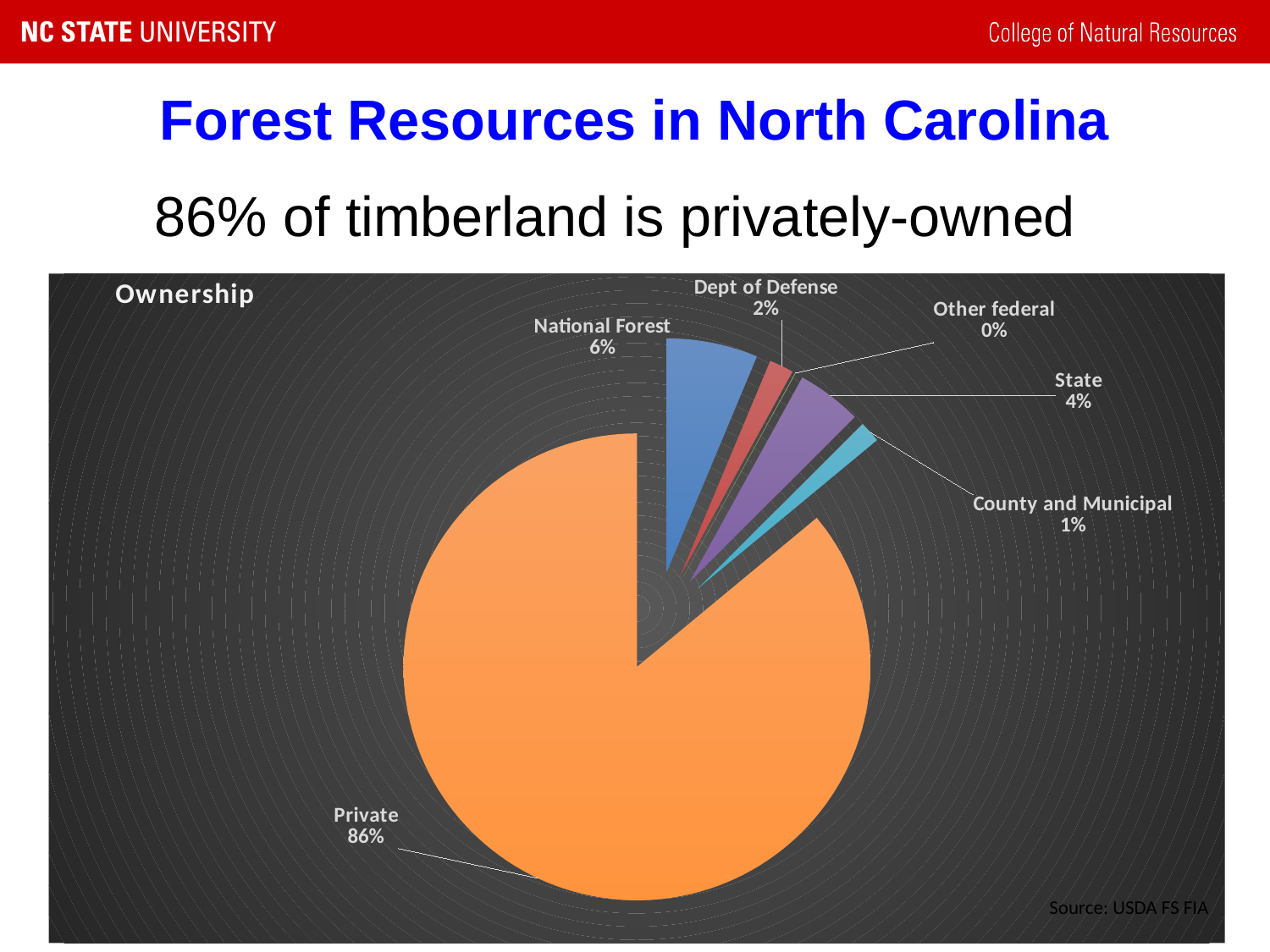
What share of timberland ownership is Other federal? 0% What share of timberland ownership is Dept of Defense? 2% What share of timberland ownership is County and Municipal? 1% What share of timberland ownership is State? 4% Which ownership category has the largest slice of the pie? Private What type of chart is shown on the slide? pie chart How many ownership categories are shown in the pie chart? 6 What share of timberland ownership is Private? 86% What is the difference between the National Forest share and the State share? 2% What is the title of the chart? Ownership Which ownership category has the smallest slice of the pie? Other federal What share of timberland ownership is National Forest? 6%